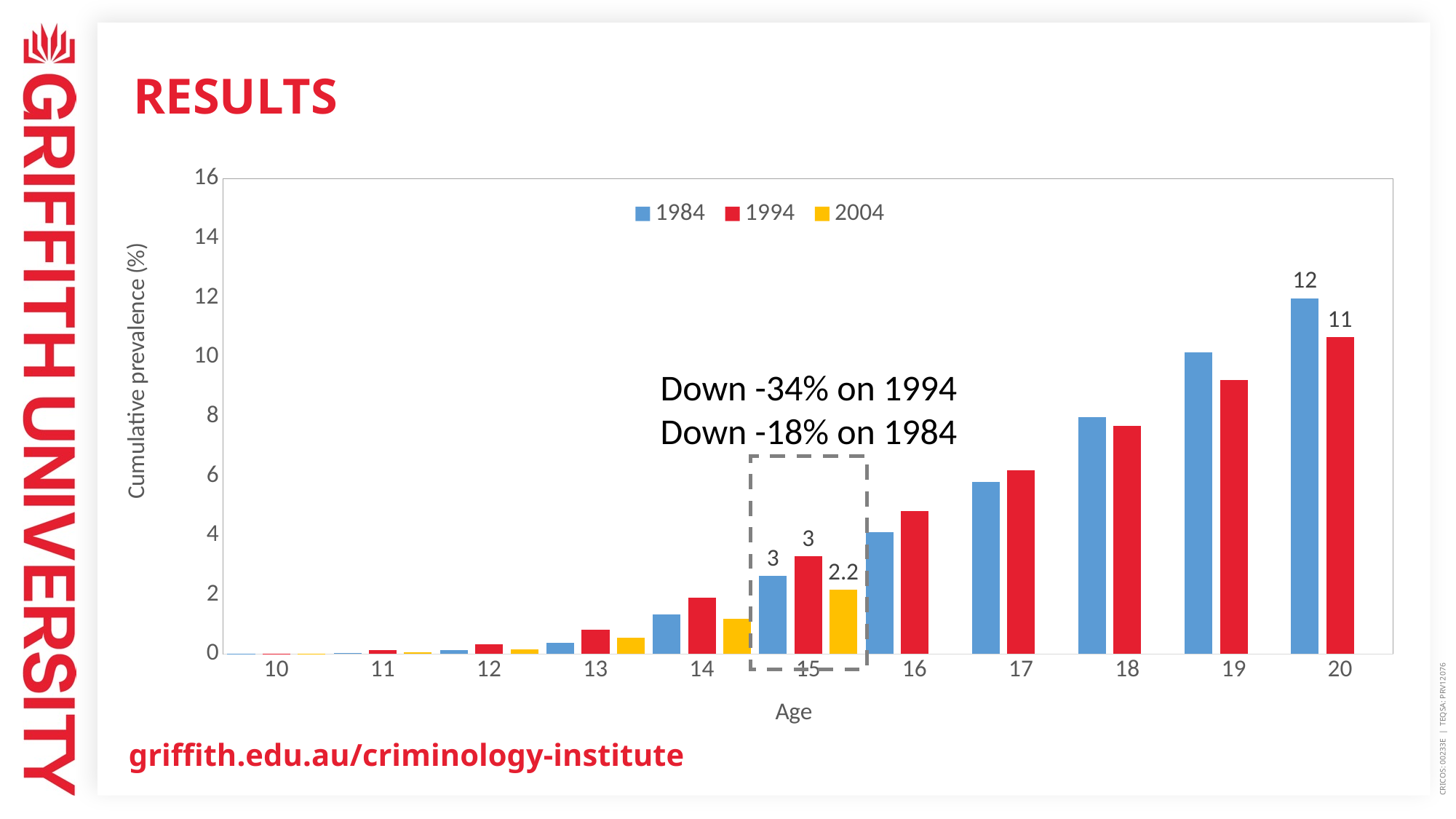
How many age categories are shown on the x axis? 11 How many series does the legend list? 3 What is the label on the y axis? Cumulative prevalence (%) Do the values for the 1984 series rise or fall as age increases? rise Is the value for the 1994 series at age 19 greater or less than 8? greater What kind of chart is shown on the slide? bar chart What is the difference between the 1984 and 1994 values at age 20? 1 What is the value for the 1984 series at age 20? 12 Is the value for the 1994 series at age 16 greater or less than 4? greater At age 15, which is larger: the 1984 value or the 2004 value? 1984 What is the value for the 2004 series at age 15? 2.2 What is the value for the 1994 series at age 20? 11